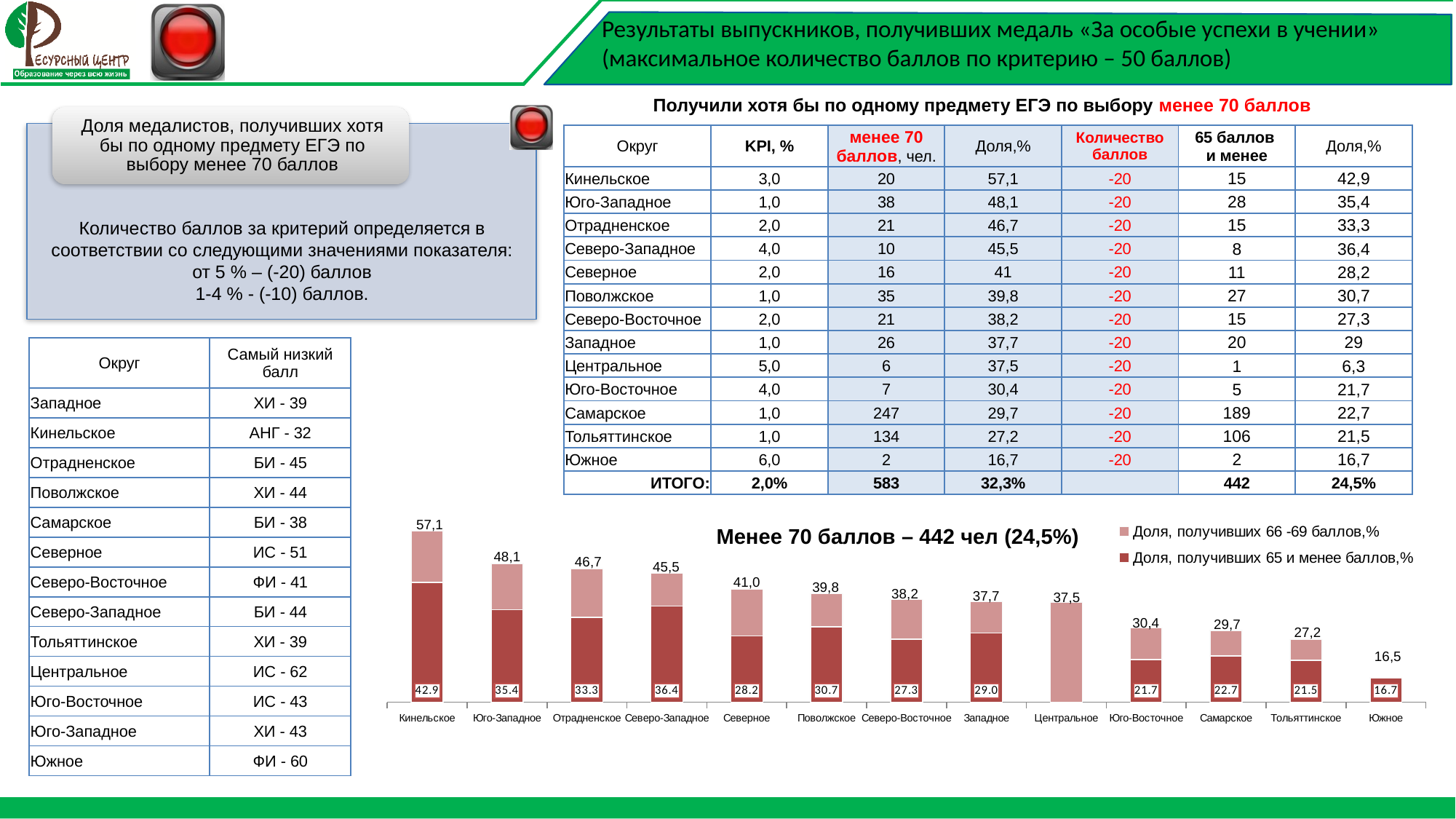
Do the total bar values in the bar chart rise or fall from left to right? Fall In the bar chart, what value is labelled on the dark red segment for Тольяттинское? 21.5 How many series does the legend of the bar chart list? 2 What kind of chart is shown at the bottom right of the slide? Stacked bar chart In the bar chart, what value is labelled on the dark red segment for Самарское? 22.7 Which district has the highest total bar in the bar chart? Кинельское In the bar chart, what is the difference between the total labelled for Кинельское and the total labelled for Южное? 40,6 Which district has the lowest total bar in the bar chart? Южное How many districts (categories) are plotted on the bar chart? 13 In the bar chart, what is the total value labelled above the bar for Кинельское? 57,1 What is the title of the bar chart? Менее 70 баллов – 442 чел (24,5%) In the bar chart, which has the larger total value: Юго-Западное or Отрадненское? Юго-Западное